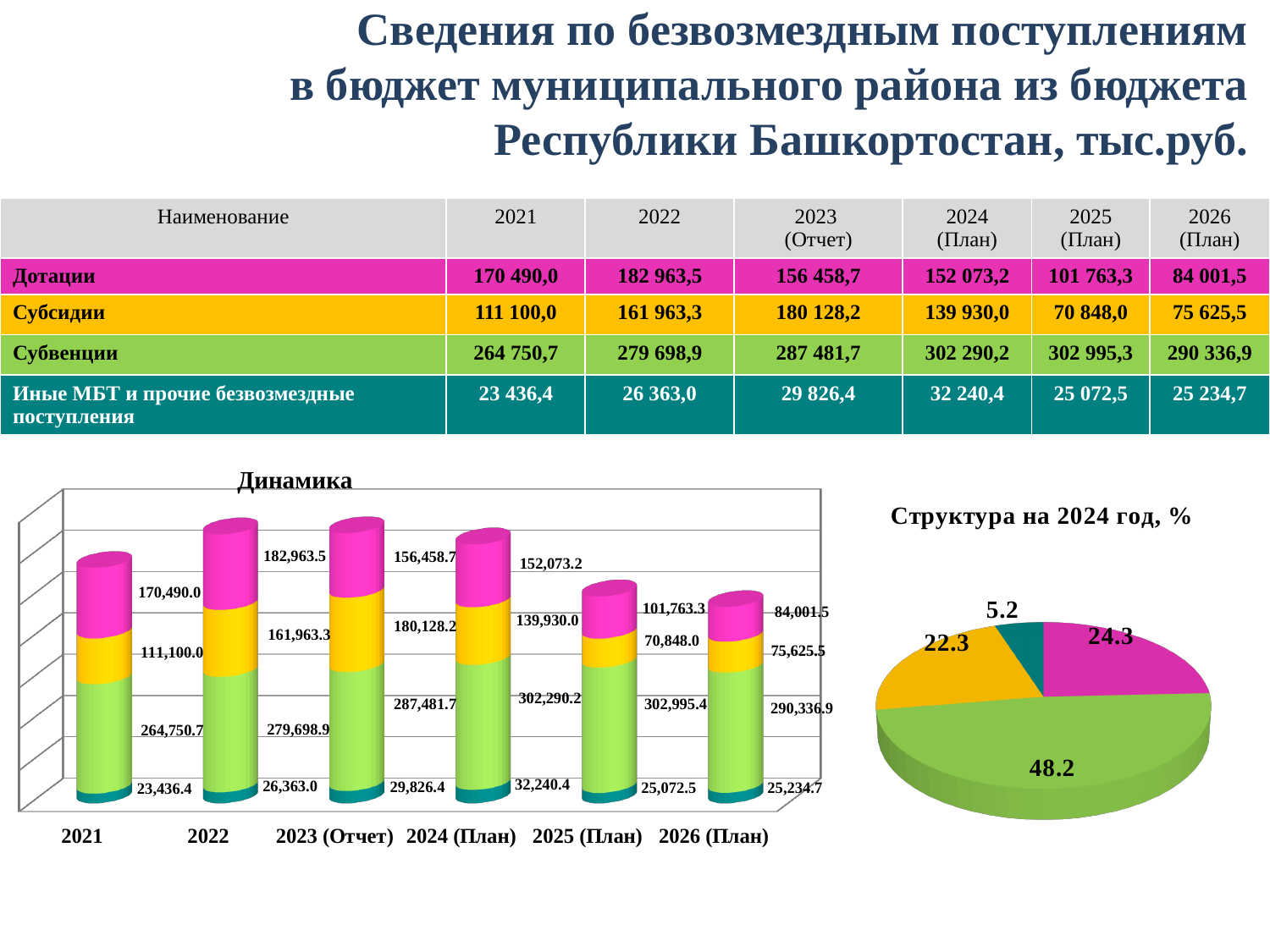
In the "Динамика" chart, what is the value of the teal bottom segment for 2026 (План)? 25,234.7 In the "Динамика" chart, what is the value of the green (Субвенции) segment for 2024 (План)? 302,290.2 How many years (bars) are shown on the x axis of the "Динамика" chart? 6 In the pie chart "Структура на 2024 год, %", what is the share of the largest slice? 48.2 In the "Динамика" chart, does the pink (Дотации) segment rise or fall from 2022 to 2026 (План)? fall In the "Динамика" chart, what is the difference between the green (Субвенции) segment values for 2024 (План) and 2021? 37,539.5 In the "Динамика" chart, what is the total of the stacked bar for 2021? 569,777.1 What type of chart is the "Динамика" chart on the left? bar chart In the "Динамика" chart, which year has the lowest value for the pink (Дотации) segment? 2026 (План) In the "Динамика" chart, which year has the highest value for the yellow (Субсидии) segment? 2023 (Отчет) In the "Динамика" chart, what is the value of the pink (Дотации) segment for 2021? 170,490.0 In the pie chart "Структура на 2024 год, %", how many slices are there? 4